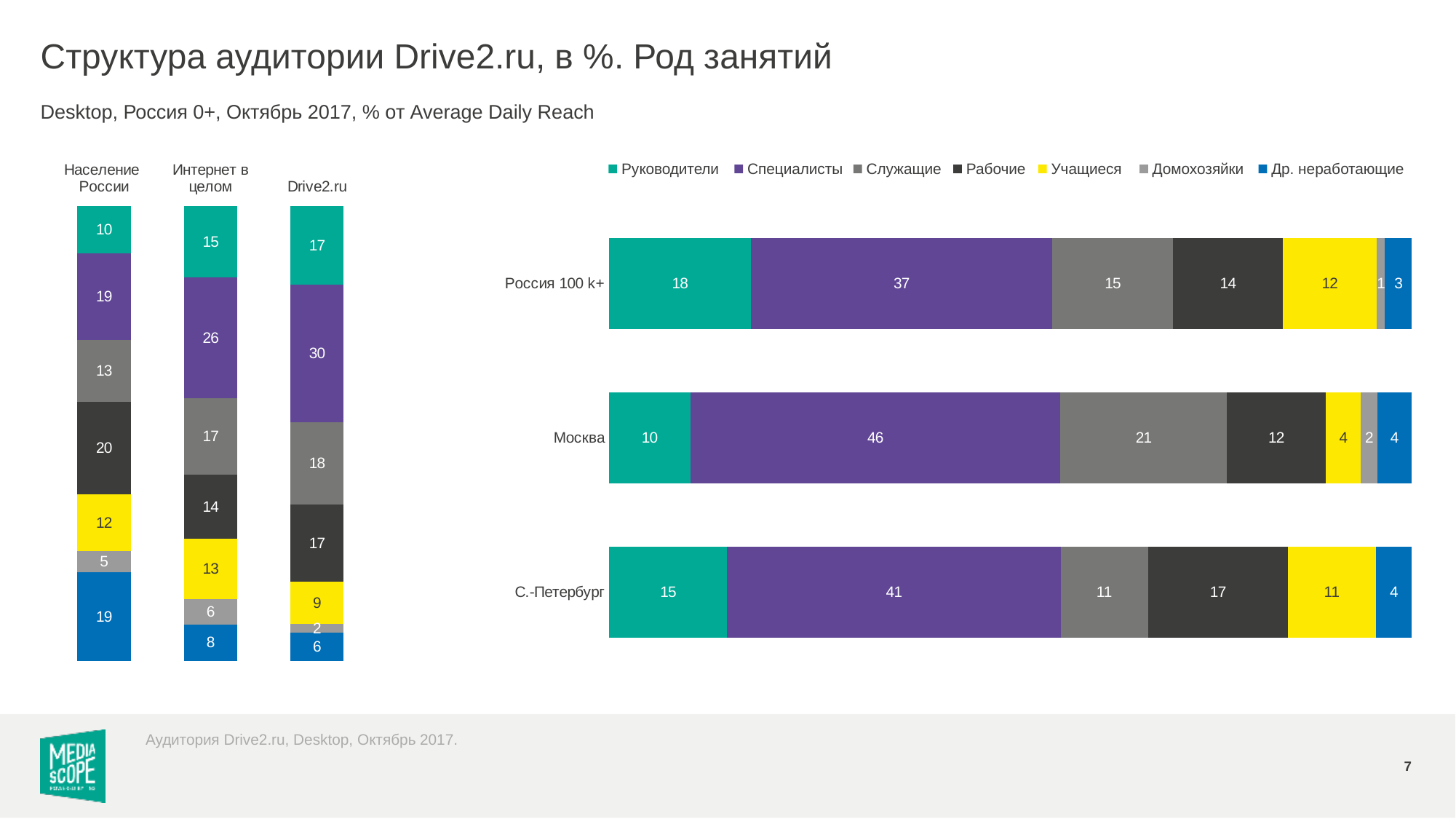
What kind of chart is the right chart? Stacked bar chart How many categories (bars) does the right chart show? 3 In the left chart, which bar has the lowest value for Домохозяйки? Drive2.ru In the right chart, what is the difference between the Руководители values for Россия 100 k+ and Москва? 8 In the right chart, what is the value for Специалисты in Москва? 46 In the left chart, what is the difference between the Специалисты values for Drive2.ru and Население России? 11 In the right chart, what is the total of the Россия 100 k+ bar? 100 In the right chart, what is the value for Учащиеся in С.-Петербург? 11 In the right chart, which category has the highest value for Специалисты? Москва In the left chart, what is the value for Руководители in the Drive2.ru bar? 17 In the left chart, which is larger for Рабочие: Население России or Drive2.ru? Население России How many series does the legend list? 7